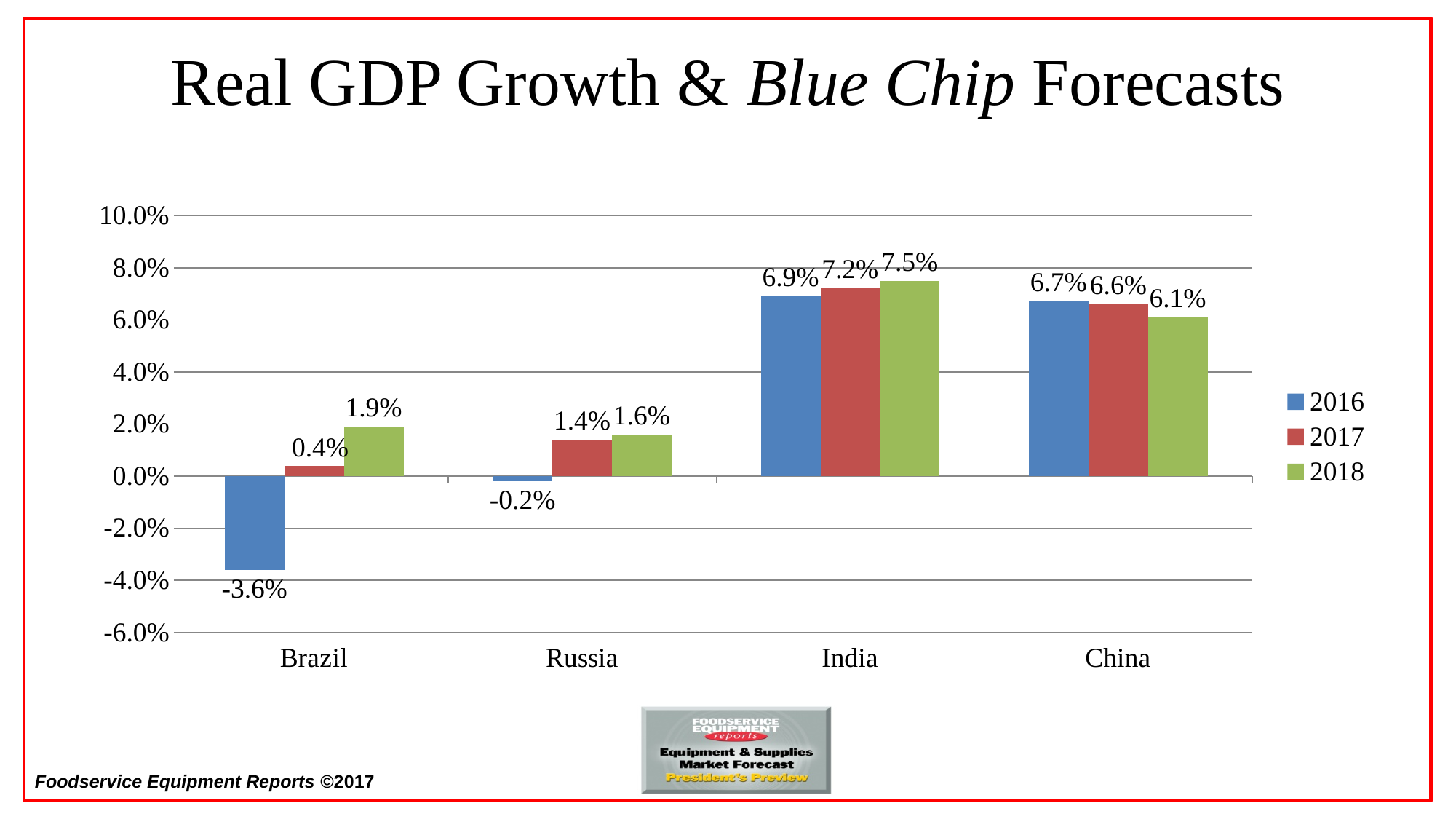
Which is larger, the 2017 value for India or the 2017 value for China? India What is the 2016 value for Brazil? -3.6% Do China's values rise or fall from 2016 to 2018? Fall What is the difference between the 2018 and 2016 values for Brazil? 5.5% How many countries are shown on the x axis? 4 Which country has the lowest 2016 value? Brazil What kind of chart is shown on the slide? Bar chart What is the 2018 value for China? 6.1% What is the 2017 value for Russia? 1.4% How many series does the legend list? 3 Which country has the highest 2018 value? India What is the 2018 value for India? 7.5%